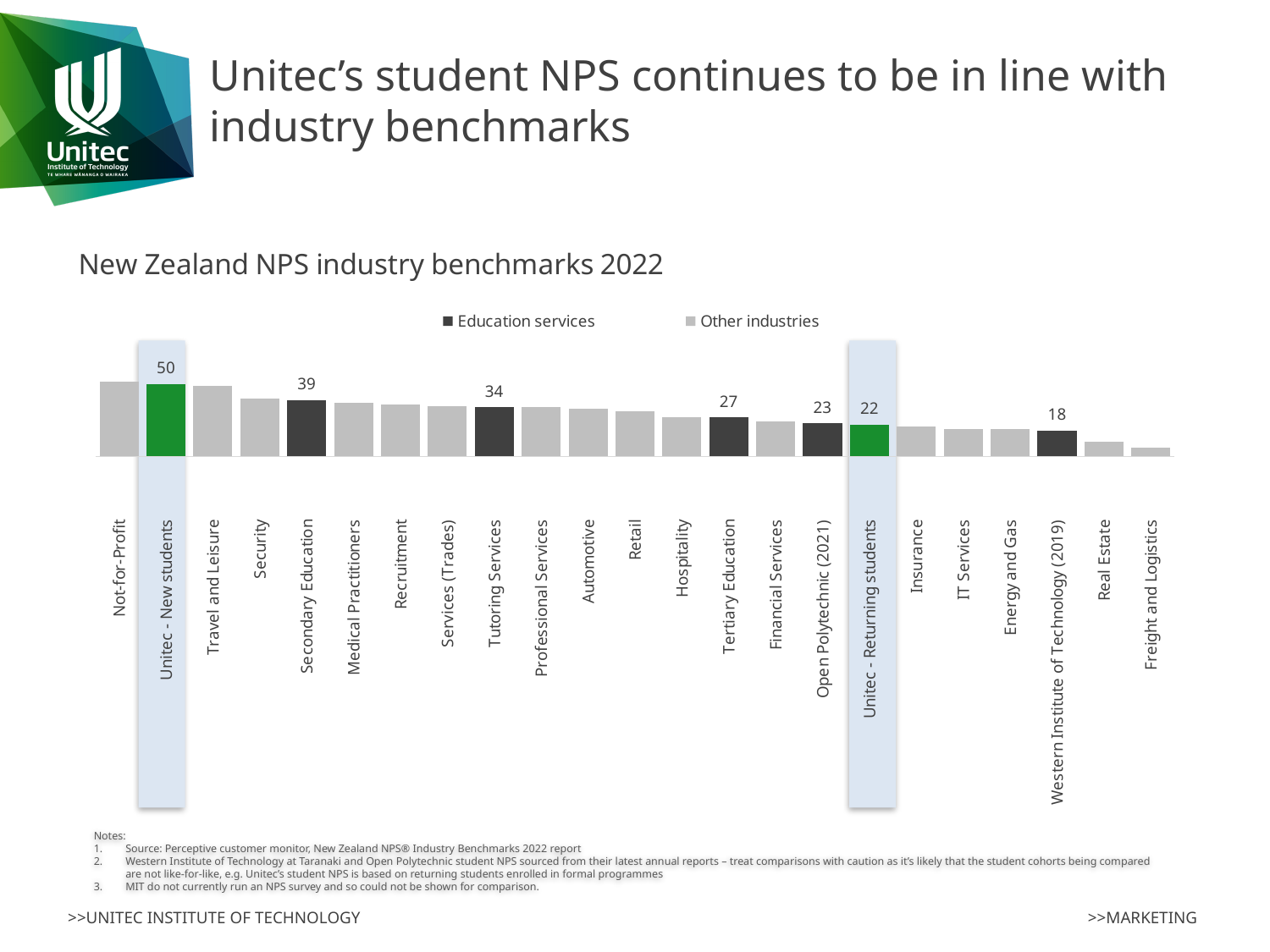
How many categories are shown along the x axis of the chart? 23 What is the NPS value shown for Western Institute of Technology (2019)? 18 What is the NPS value for Unitec - Returning students? 22 Do the bar values generally rise or fall from left to right across the chart? fall What is the difference between the NPS for Tertiary Education and Open Polytechnic (2021)? 4 What is the NPS value shown for Open Polytechnic (2021)? 23 Which category has the lowest bar in the chart? Freight and Logistics What is the NPS value shown for Secondary Education? 39 What is the difference between the NPS for Unitec - New students and Unitec - Returning students? 28 What is the NPS value for Unitec - New students? 50 How many series does the legend list? 2 Which has a higher NPS, Secondary Education or Tutoring Services? Secondary Education